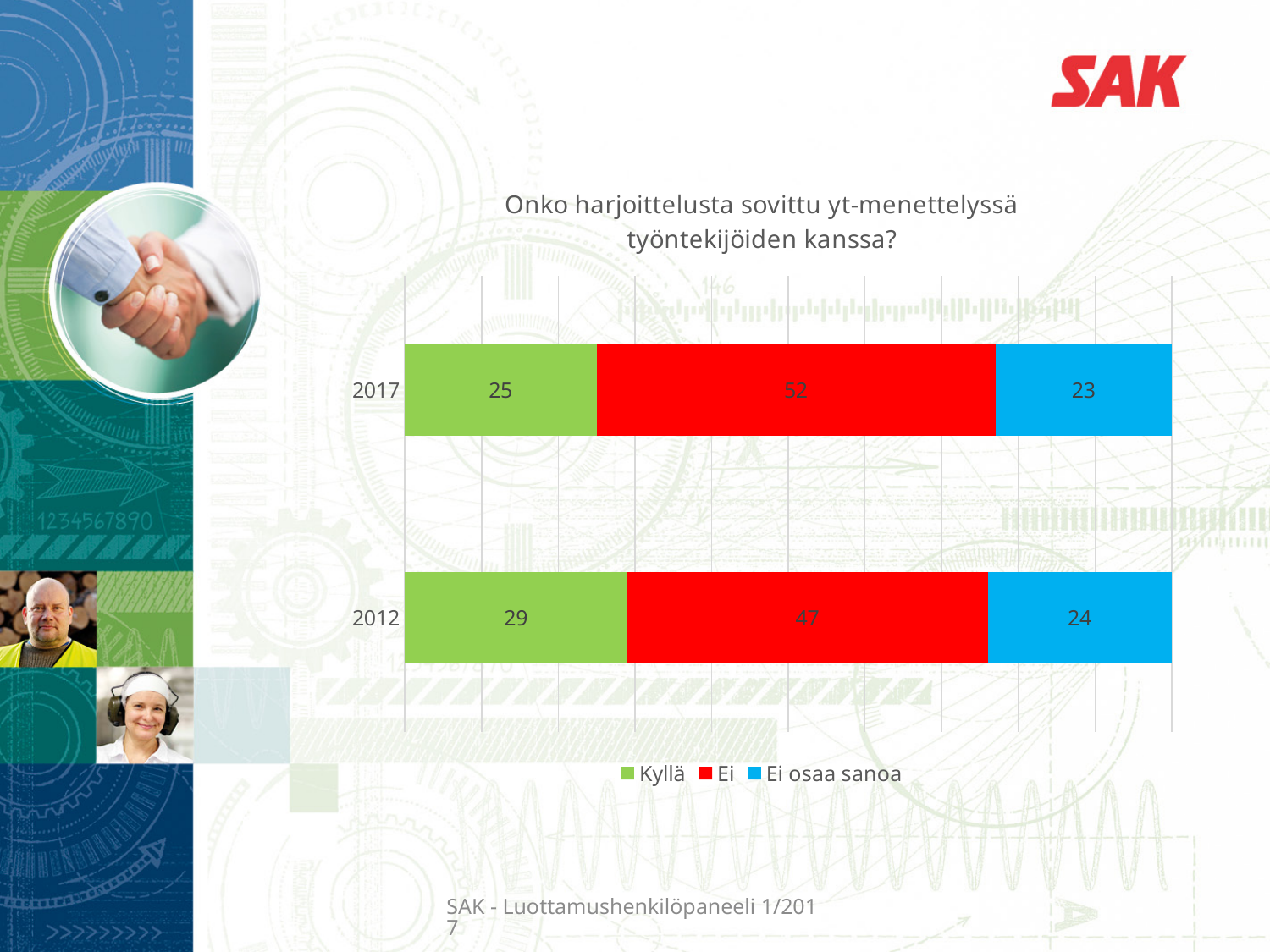
Which series has the lowest value in 2012? Ei osaa sanoa What is the total of the stacked bar for 2012? 100 Which year has the larger value for "Kyllä", 2017 or 2012? 2012 What is the value for "Kyllä" in 2012? 29 What kind of chart is shown on the slide? Stacked bar chart What is the value for "Ei" in 2012? 47 What is the difference between the "Ei" values for 2017 and 2012? 5 What is the value for "Kyllä" in 2017? 25 Which series has the highest value in 2017? Ei What is the value for "Ei osaa sanoa" in 2017? 23 How many series does the legend list? 3 How many years (categories) are shown in the chart? 2